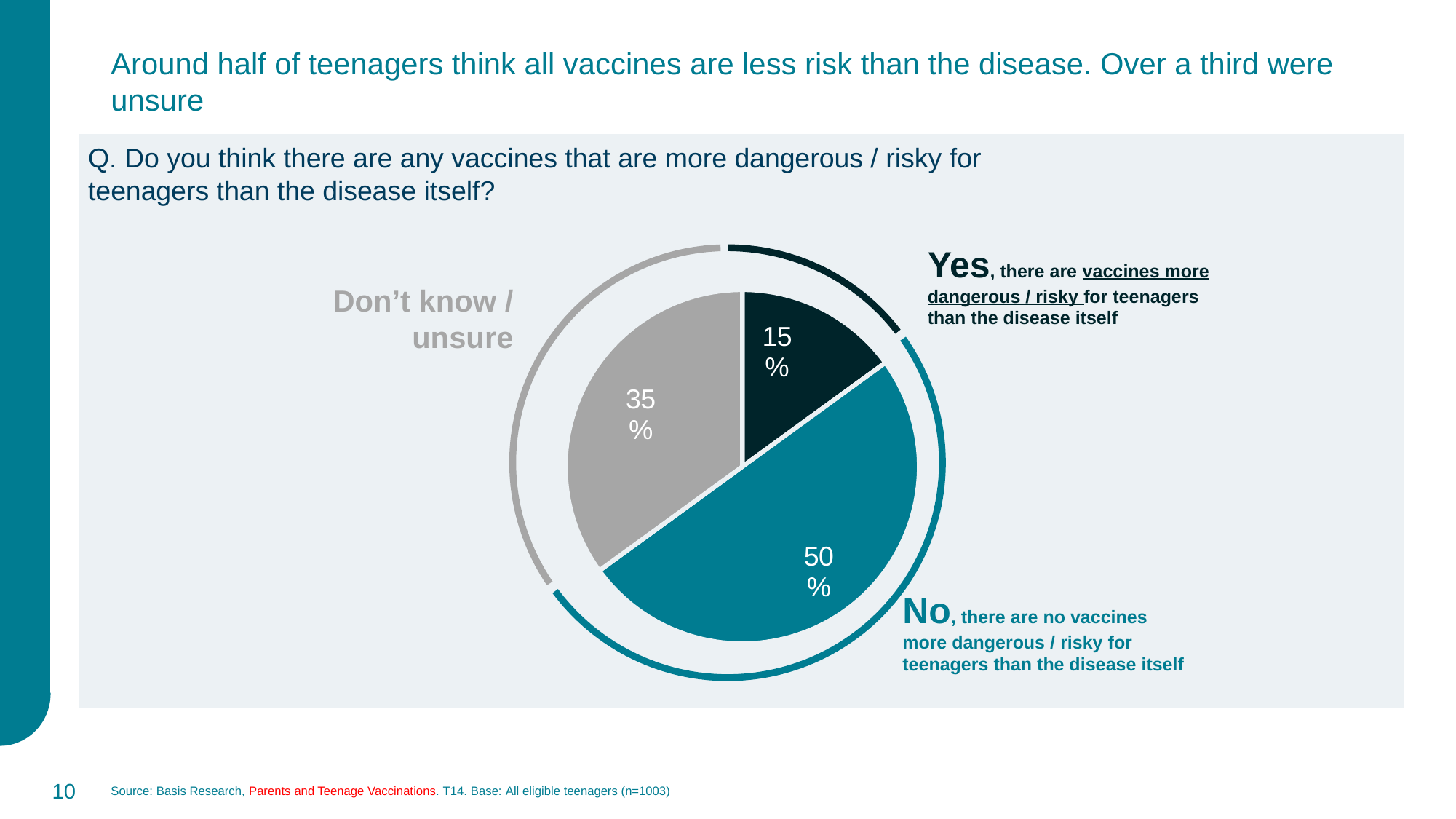
What is the difference in percentage points between the "No" and "Yes" responses? 35 Which response has the largest share of the pie? No, there are no vaccines more dangerous / risky for teenagers than the disease itself What is the difference in percentage points between the "Don't know / unsure" and "Yes" responses? 20 What colour is the "Don't know / unsure" slice of the pie? Grey How many response categories are shown in the pie chart? 3 What percentage of teenagers answered "Don't know / unsure"? 35% What percentage of teenagers answered "Yes, there are vaccines more dangerous / risky for teenagers than the disease itself"? 15% What type of chart is shown on the slide? Pie chart Which response has the smallest share of the pie? Yes, there are vaccines more dangerous / risky for teenagers than the disease itself What percentage of teenagers answered "No, there are no vaccines more dangerous / risky for teenagers than the disease itself"? 50% Which is larger: the share for "Don't know / unsure" or the share for "Yes"? Don't know / unsure What is the combined share of the "Yes" and "Don't know / unsure" responses? 50%